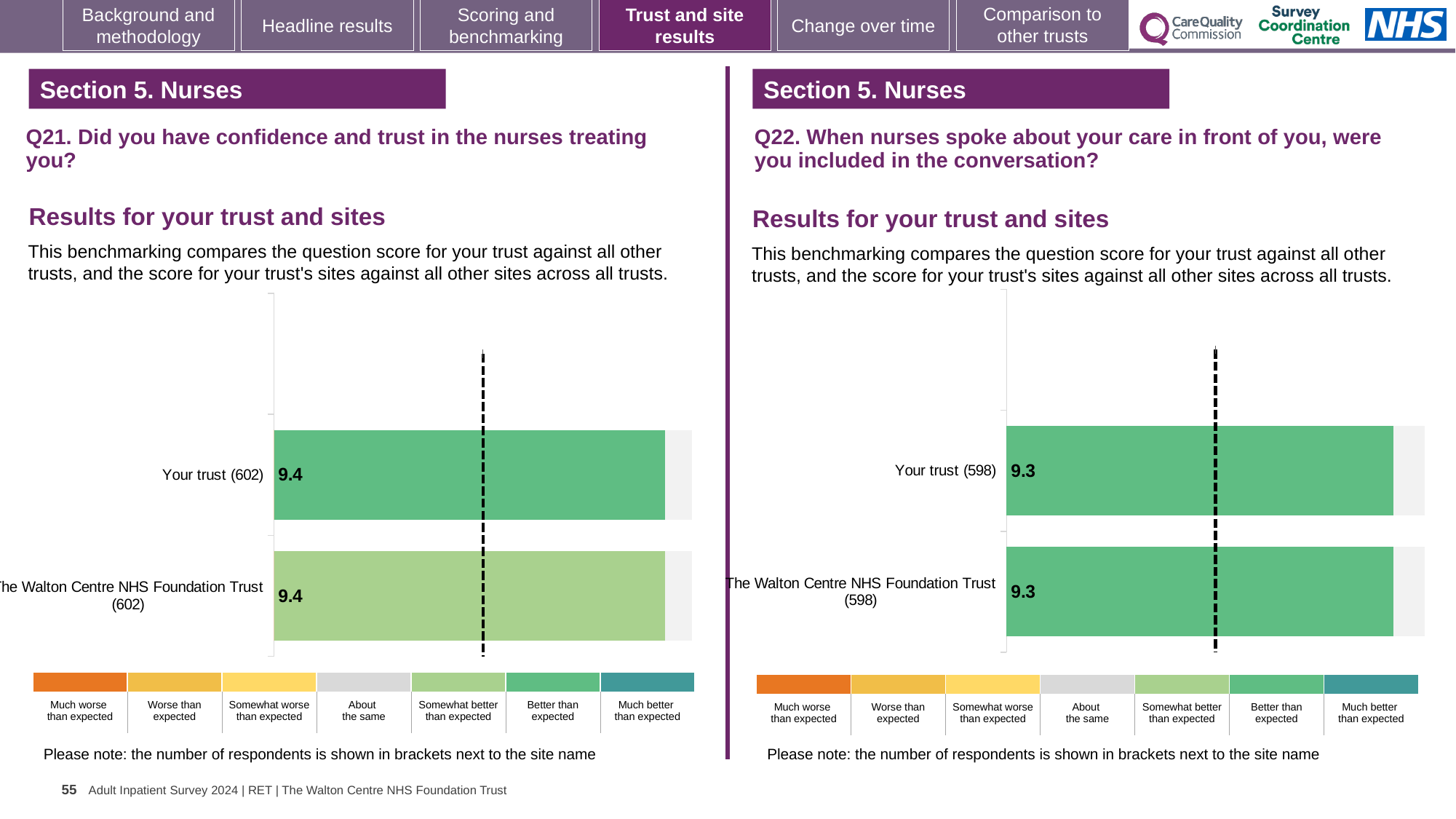
In the Q22 chart on the right, what is the score for Your trust (598)? 9.3 How many bars are plotted in the Q22 chart on the right? 2 What kind of chart is used for the Q21 results on the left? Bar chart In the Q21 chart on the left, what is the score for The Walton Centre NHS Foundation Trust (602)? 9.4 In the Q22 chart on the right, what is the score for The Walton Centre NHS Foundation Trust (598)? 9.3 In the Q21 chart on the left, which benchmark category does the colour of the bar for The Walton Centre NHS Foundation Trust (602) correspond to? Somewhat better than expected In the Q22 chart on the right, which benchmark category does the colour of the bar for Your trust (598) correspond to? Better than expected In the Q22 chart on the right, what is the difference between the score for Your trust and the score for The Walton Centre NHS Foundation Trust? 0.0 How many respondents are shown in brackets for Your trust in the Q22 chart on the right? 598 In the Q21 chart on the left, what is the score for Your trust (602)? 9.4 How many bars are plotted in the Q21 chart on the left? 2 In the Q21 chart on the left, what is the difference between the score for Your trust and the score for The Walton Centre NHS Foundation Trust? 0.0